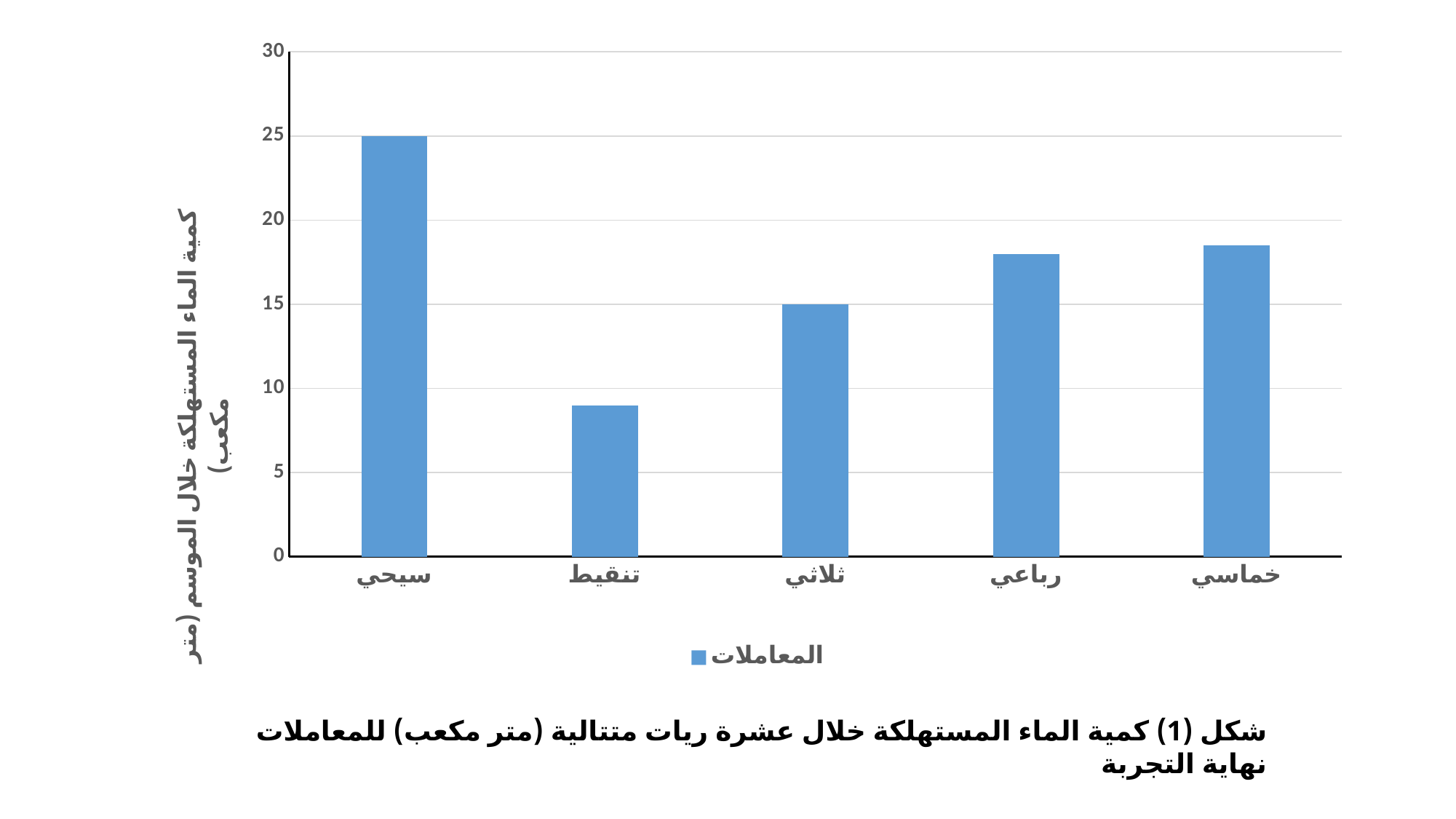
Is the value for تنقيط greater or less than 10? less How many series does the legend list? 1 What type of chart is shown on the slide? bar chart What is the name of the series shown in the legend? المعاملات What is the difference between the values for سيحي and ثلاثي? 10 What is the value for ثلاثي? 15 Which category has the lowest value? تنقيط Which is larger, the value for رباعي or the value for ثلاثي? رباعي What is the value for سيحي? 25 How many categories are shown on the x axis of the chart? 5 Is the value for خماسي greater or less than 15? greater Which category has the highest value? سيحي